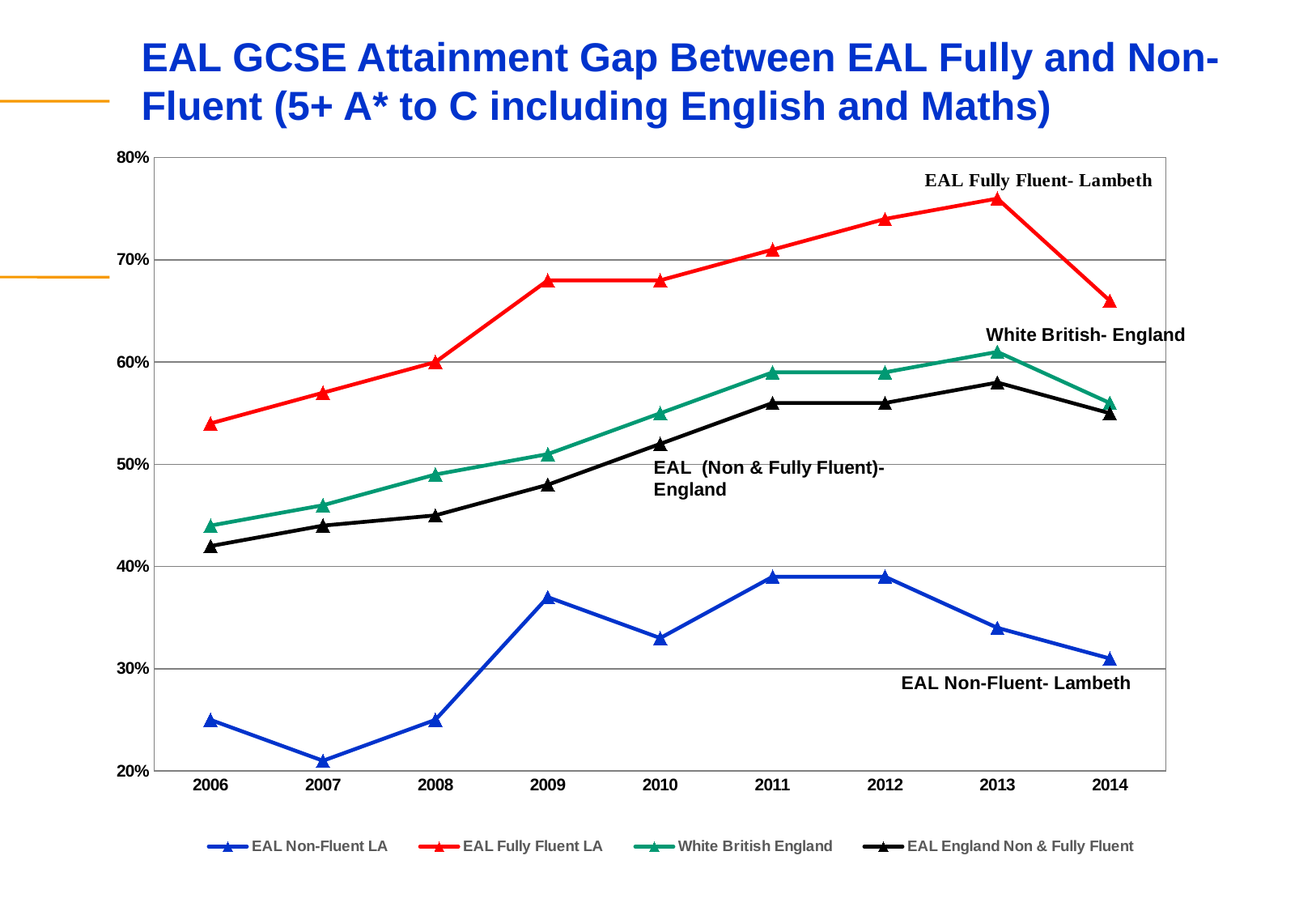
How many years are shown on the x axis? 9 How many series does the legend list? 4 In which year does the EAL Non-Fluent LA series reach its lowest value? 2007 In 2014, which is larger: EAL Fully Fluent LA or White British England? EAL Fully Fluent LA Is the value for EAL Non-Fluent LA in 2007 greater or less than 30%? less What kind of chart is shown on the slide? line chart Which series has the highest value in 2013? EAL Fully Fluent LA Which series has the lowest value in 2006? EAL Non-Fluent LA Is the value for EAL Fully Fluent LA in 2013 greater or less than 70%? greater In which year does the EAL Fully Fluent LA series reach its highest value? 2013 Does the EAL Fully Fluent LA series rise or fall from 2006 to 2013? rise Is the value for White British England in 2014 greater or less than 60%? less